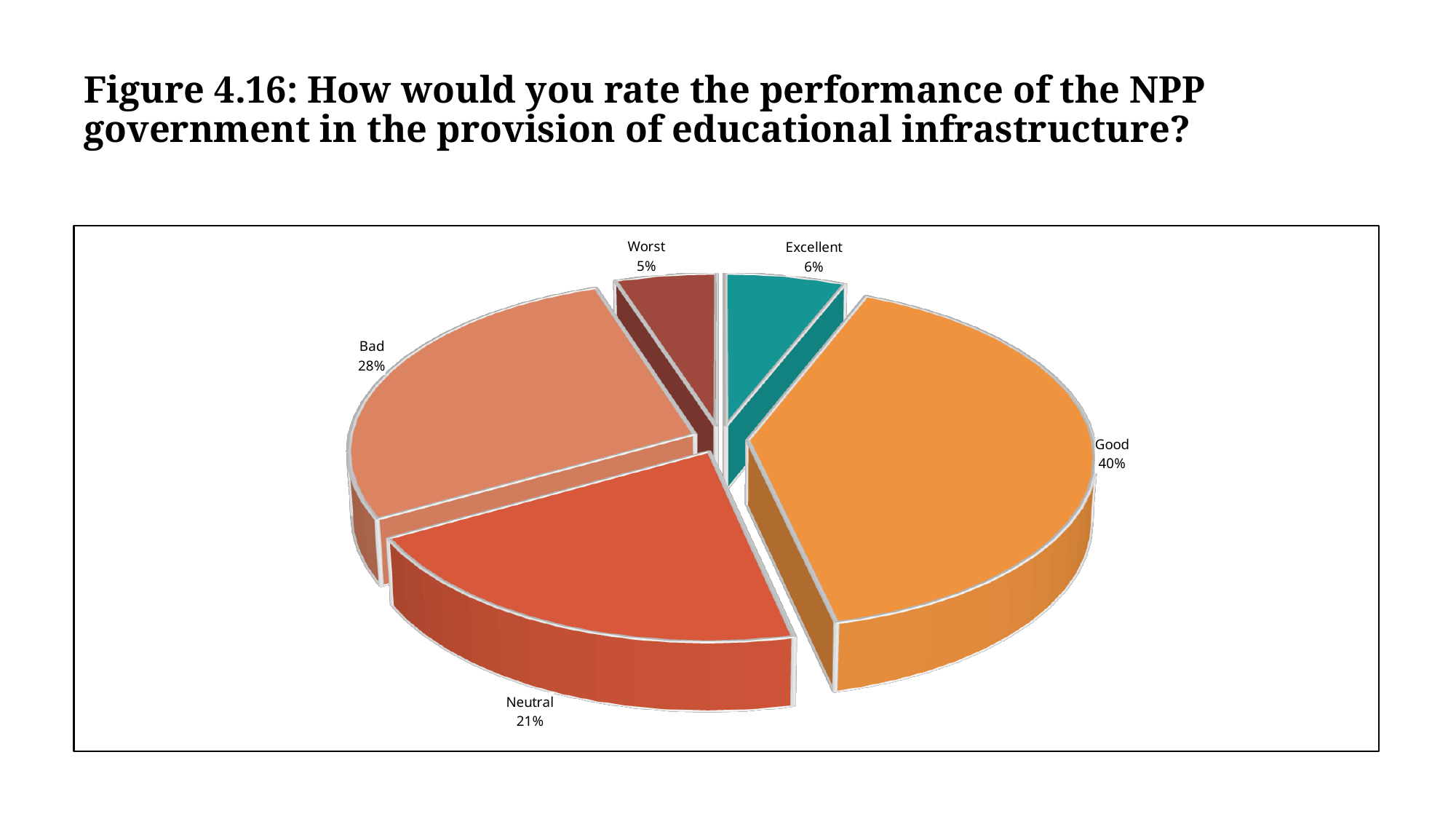
Which is larger, the Bad slice or the Neutral slice? Bad What colour is the Good slice? Orange How many categories are shown in the pie chart? 5 What percentage is shown for the Neutral slice? 21% What type of chart is shown on the slide? Pie chart What percentage of respondents chose Bad? 28% What is the difference in percentage points between the Good and Bad slices? 12 Which rating category has the smallest share of the pie? Worst What percentage of respondents rated the performance as Excellent? 6% What is the combined share of the Excellent and Worst slices? 11% What share of respondents rated the NPP government's performance as Good? 40% Which rating category has the largest share of the pie? Good